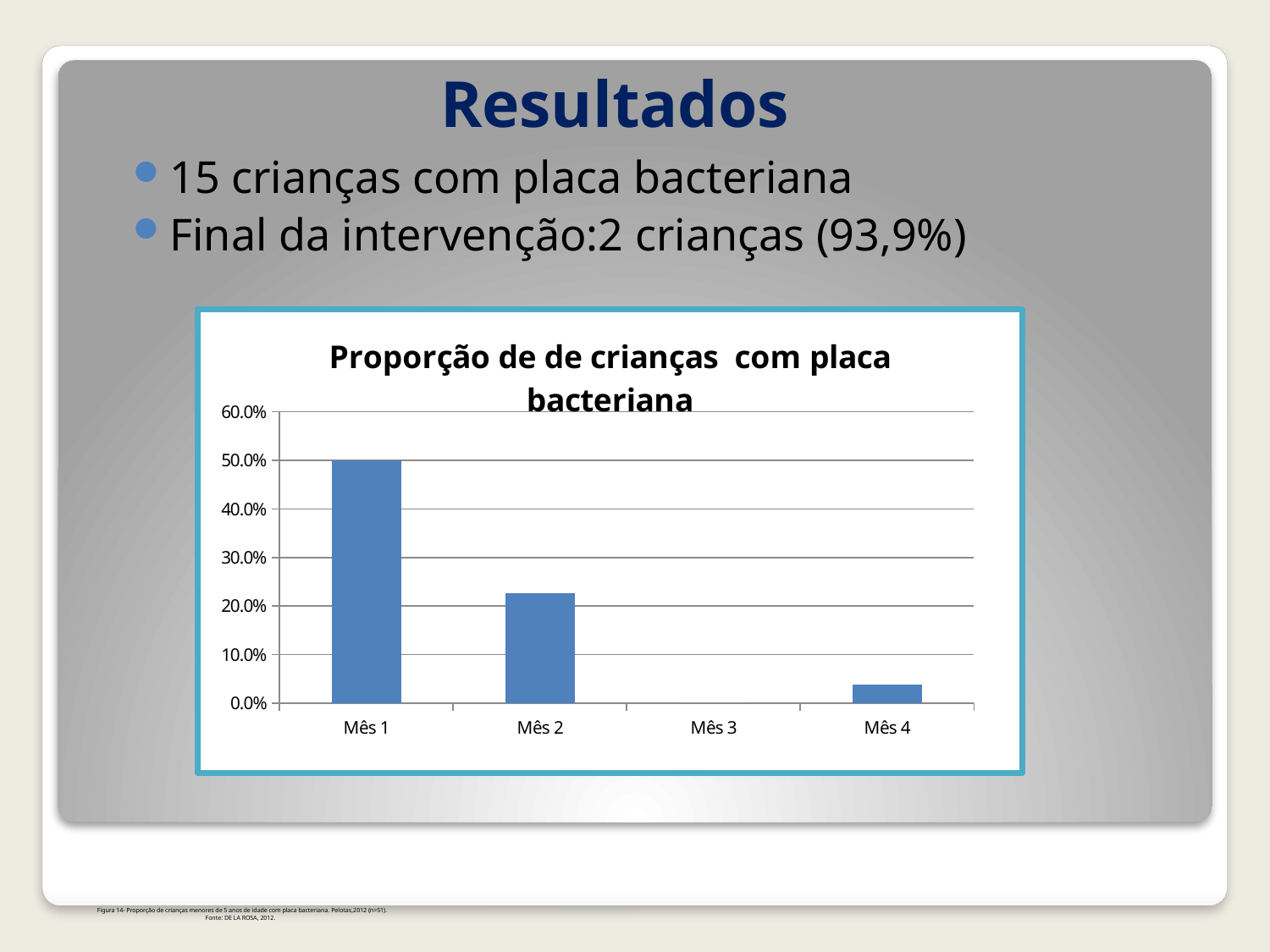
What type of chart is shown on the slide? bar chart Which is larger, the value for Mês 1 or the value for Mês 2? Mês 1 Is the value for Mês 4 greater or less than 10.0%? less Is the value for Mês 2 greater or less than 20.0%? greater What is the value for Mês 1? 50.0% What is the title of the chart? Proporção de de crianças com placa bacteriana Is the value for Mês 2 greater or less than 30.0%? less Which is larger, the value for Mês 2 or the value for Mês 4? Mês 2 How many categories are shown on the x axis of the chart? 4 Which month has the lowest proportion of children with bacterial plaque? Mês 3 Do the values rise or fall from Mês 1 to Mês 3? fall Which month has the highest proportion of children with bacterial plaque? Mês 1